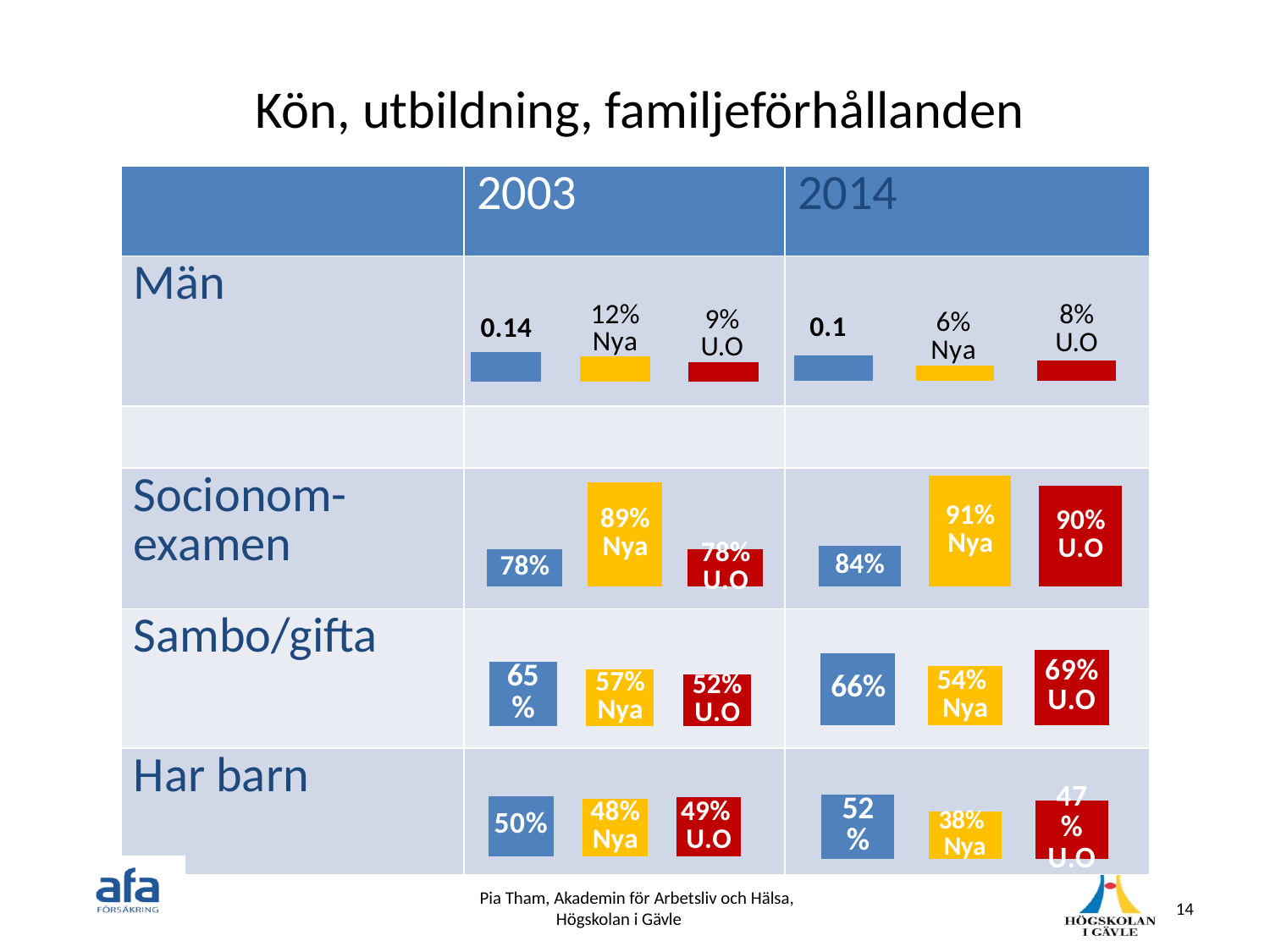
In the Socionom-examen row for 2014, what is the value for Nya? 91% In the Män row for 2014, which is larger, the Nya value or the U.O value? U.O In the Socionom-examen row for 2003, what is the difference between the Nya value and the U.O value? 11% In the Socionom-examen row for 2014, which bar is the lowest? 84% (blue bar) In the Har barn row for 2014, what is the value for Nya? 38% How many bars are shown in each cell of the table? 3 In the Män row for 2003, what is the value for Nya? 12% In the Sambo/gifta row for 2003, which is larger, the Nya value or the U.O value? Nya In the Sambo/gifta row for 2003, what is the value for U.O? 52% In the Har barn row for 2014, what is the difference between the Nya value and the U.O value? 9% What kind of chart is used in the cells of the table? Bar chart In the Sambo/gifta row for 2014, which bar is the highest? U.O